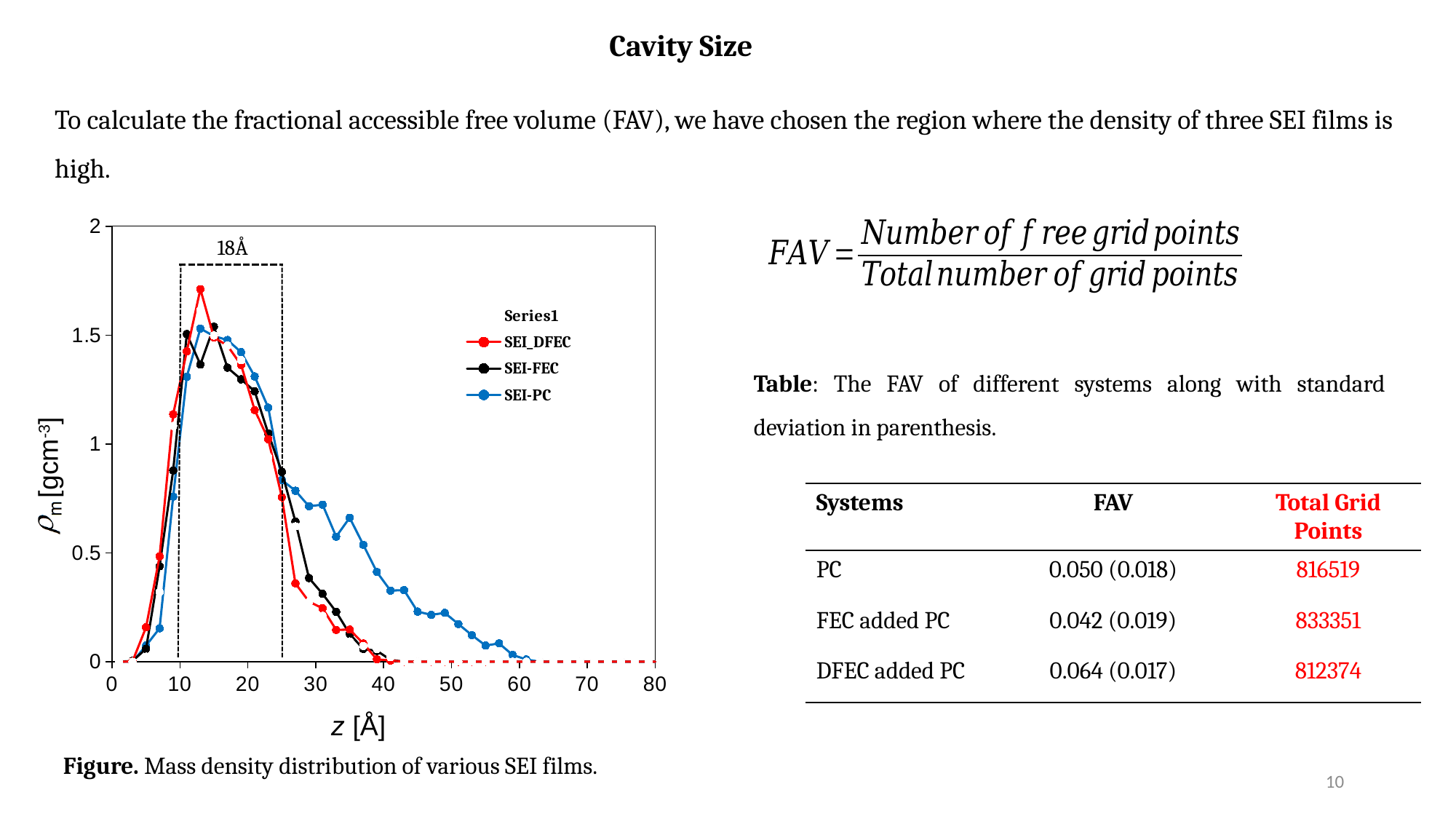
What width is labelled on the dashed box in the chart? 18Å Is the value for SEI-FEC at z = 30 Å greater or less than 0.5? less What kind of chart is shown on the slide? line chart Which series reaches the highest peak density in the chart? SEI_DFEC Is the peak value of SEI_DFEC greater or less than 1.5? greater Which series extends furthest along the z axis before dropping to zero? SEI-PC How many SEI film series are plotted in the chart? 3 Is the value for SEI-PC at z = 40 Å greater or less than 0.5? less Do the density values rise or fall along the z axis beyond z = 20 Å? fall What colour is the SEI-PC series in the chart? blue At z = 50 Å, which series has the larger density, SEI-PC or SEI_DFEC? SEI-PC At z = 35 Å, which series has the larger density, SEI-PC or SEI-FEC? SEI-PC